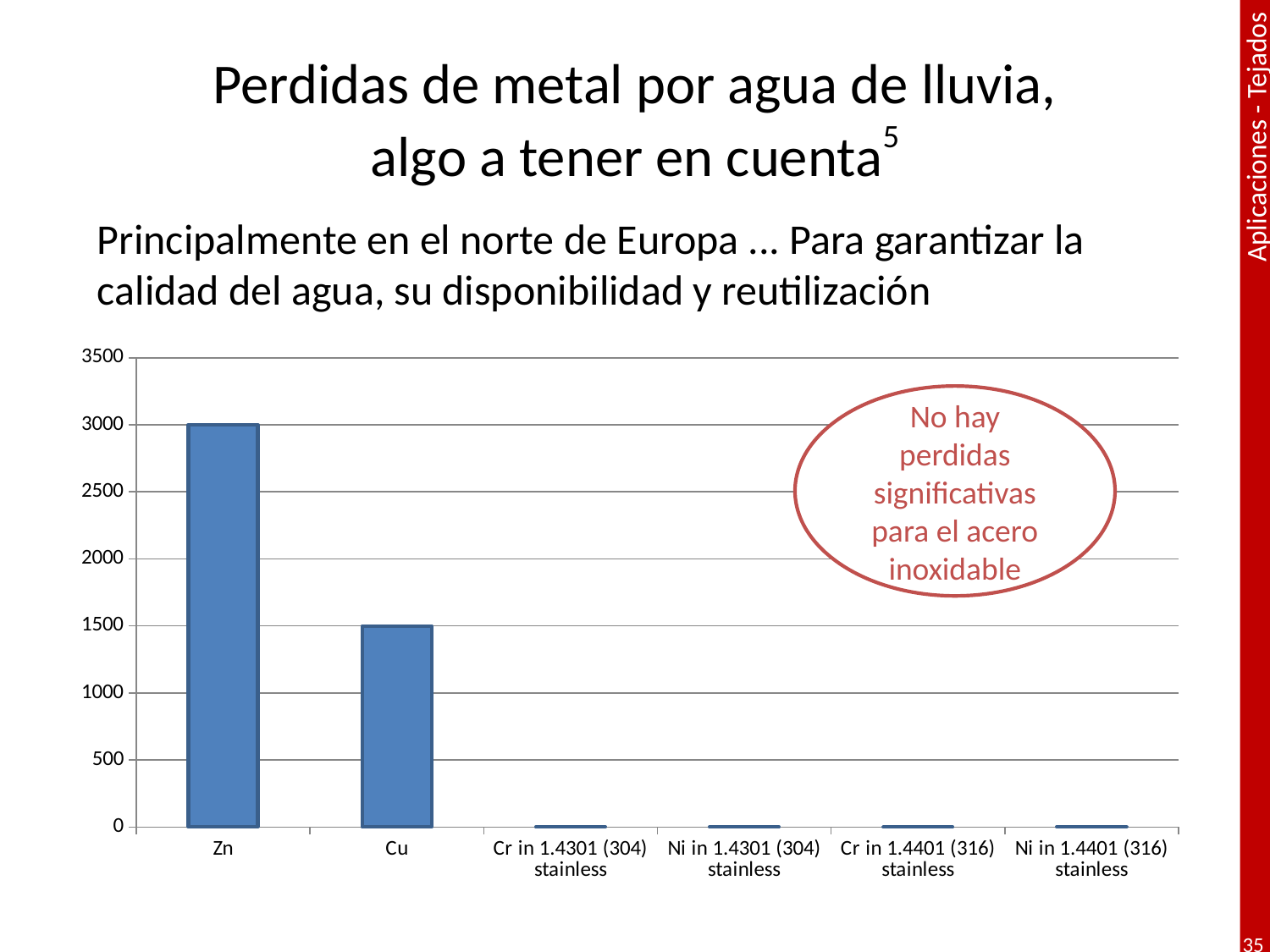
Is the value for Zn greater or less than 2500? greater How many categories are shown on the x axis of the chart? 6 Is the value for Cu greater or less than 1000? greater What kind of chart is shown on the slide? bar chart Which is larger, the value for Zn or the value for Cu? Zn Is the value for Ni in 1.4401 (316) stainless greater or less than 500? less What is the difference between the values for Zn and Cu? 1500 Which is larger, the value for Cu or the value for Cr in 1.4301 (304) stainless? Cu Which category has the highest value in the chart? Zn What is the value for Cu in the chart? 1500 What is the highest value shown on the y axis of the chart? 3500 What is the value for Zn in the chart? 3000